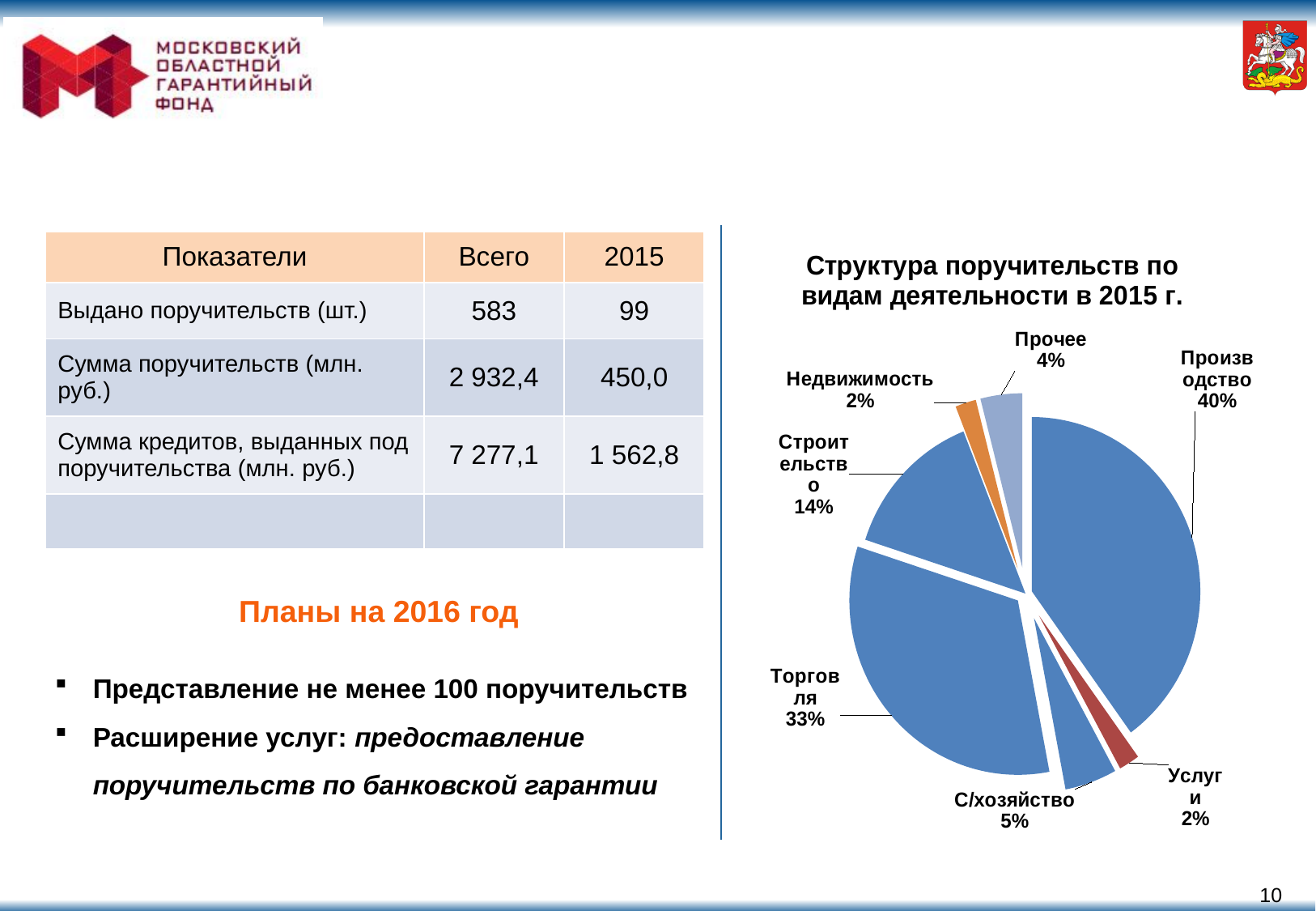
Which category has the largest share of the pie? Производство What is the combined share of Производство and Торговля? 73% What share of the pie does Торговля have? 33% What kind of chart is shown on the slide? pie chart What share of the pie does Производство have? 40% Which is larger, the share for Торговля or the share for Строительство? Торговля What is the title of the pie chart? Структура поручительств по видам деятельности в 2015 г. What share of the pie does Строительство have? 14% What share of the pie does Прочее have? 4% How many slices does the pie chart have? 7 By how many percentage points does Производство exceed Торговля? 7 What share of the pie does С/хозяйство have? 5%